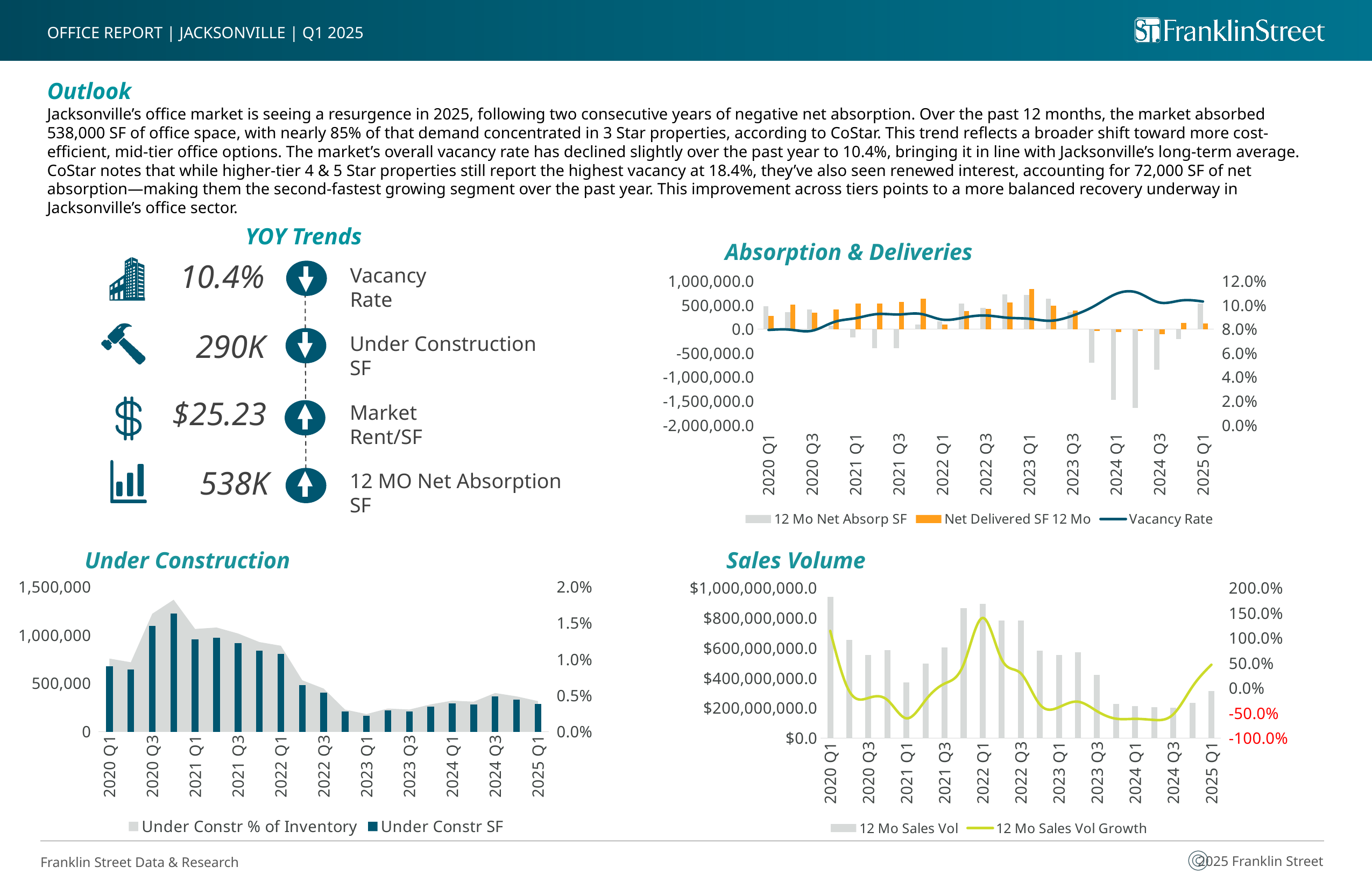
In the Under Construction chart, is the Under Constr SF for 2020 Q3 greater or less than 1,000,000? greater In the Absorption & Deliveries chart, is the 12 Mo Net Absorp SF for 2024 Q3 greater or less than -1,000,000.0? greater In the Absorption & Deliveries chart, which quarter has the highest Net Delivered SF 12 Mo bar? 2023 Q1 In the Absorption & Deliveries chart, which series is drawn as a line? Vacancy Rate In the Under Construction chart, do the Under Constr SF bars rise or fall from 2021 Q1 to 2023 Q1? fall How many series does the legend of the Under Construction chart list? 2 In the Sales Volume chart, is the 12 Mo Sales Vol for 2020 Q1 greater or less than $800,000,000.0? greater How many series does the legend of the Sales Volume chart list? 2 How many series does the legend of the Absorption & Deliveries chart list? 3 In the Under Construction chart, which is larger, the Under Constr SF for 2021 Q1 or for 2023 Q1? 2021 Q1